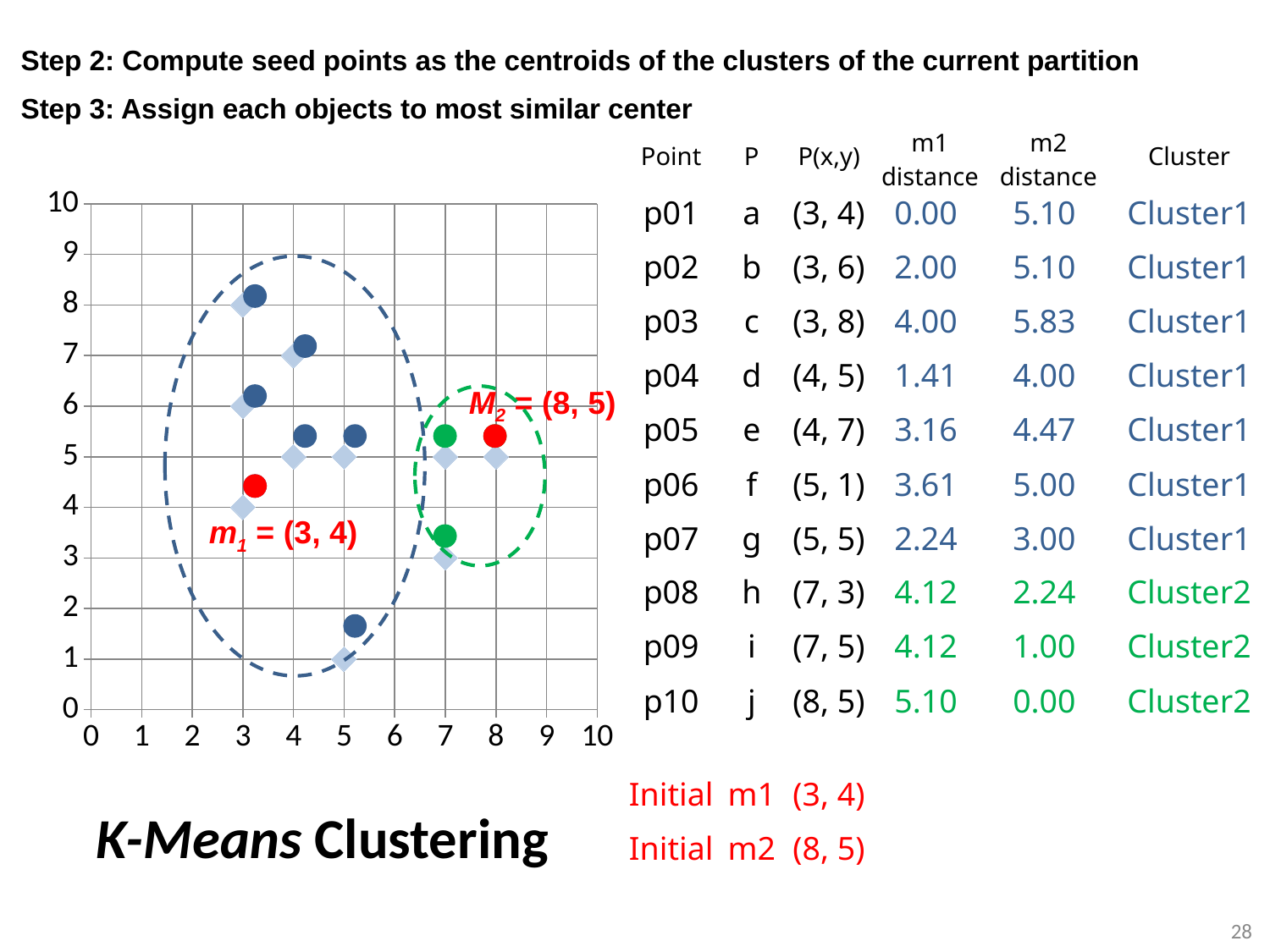
How many data points are plotted on the chart? 10 What are the coordinates of the centroid labelled m1 on the chart? (3, 4) Which plotted point has the lowest y value? (5, 1) Which plotted point has the highest y value? (3, 8) Is the x value of the lowest point on the chart greater or less than 4? greater What kind of chart is shown on the slide? scatter chart How many dashed ellipses are drawn on the chart? 2 Which centroid has the larger x coordinate, m1 or M2? M2 How many points are enclosed by the green dashed ellipse on the chart? 3 What is the maximum value shown on the x axis of the chart? 10 What are the coordinates of the centroid labelled M2 on the chart? (8, 5) What is the difference in x coordinate between centroid M2 and centroid m1? 5